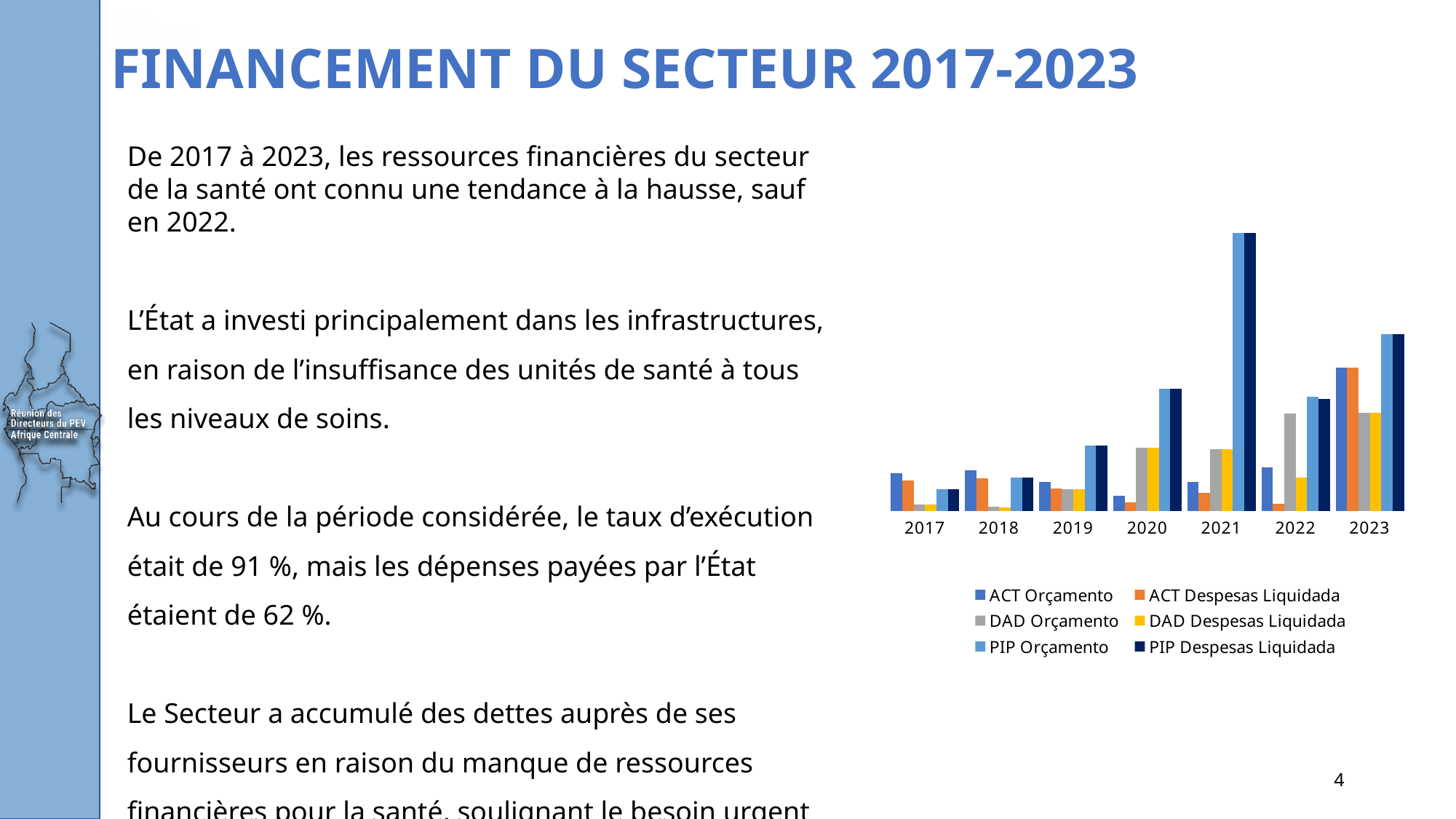
How many years are shown on the x axis of the chart? 7 How many series does the chart's legend list? 6 Which legend entry is shown in dark navy blue? PIP Despesas Liquidada Do the PIP Orçamento bars rise or fall from 2017 to 2021? Rise Which is larger, the DAD Orçamento bar for 2018 or for 2022? 2022 What is the first entry listed in the chart's legend? ACT Orçamento Which is larger in 2022, the DAD Orçamento bar or the ACT Orçamento bar? DAD Orçamento Which is larger, the PIP Orçamento bar for 2021 or for 2023? 2021 Do the PIP Despesas Liquidada bars rise or fall from 2017 to 2020? Rise What kind of chart is shown on the slide? Bar chart In which year does the chart reach its tallest bar? 2021